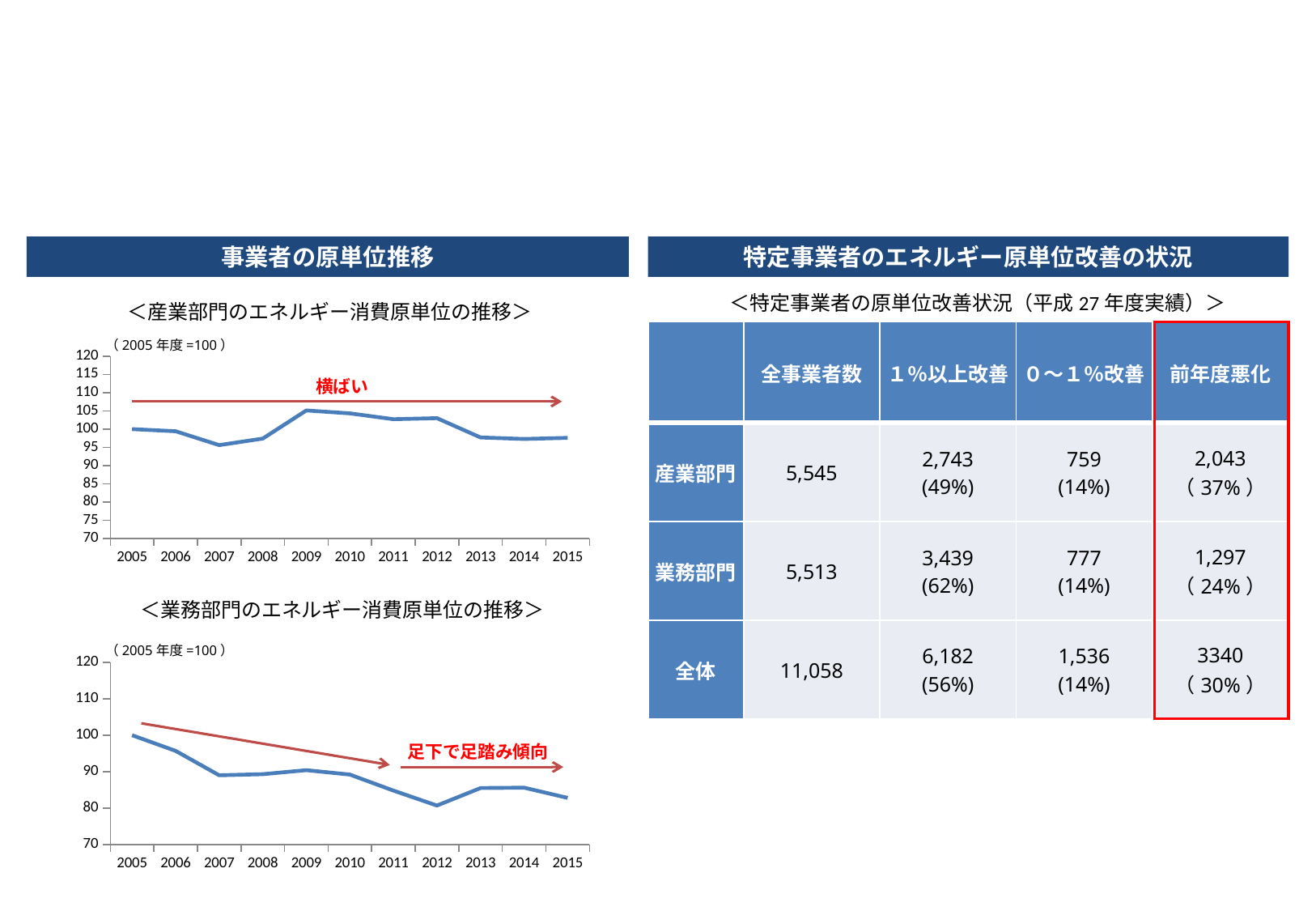
What kind of chart is the ＜産業部門のエネルギー消費原単位の推移＞ chart? line chart In the ＜業務部門のエネルギー消費原単位の推移＞ chart, which year has the highest value? 2005 In the ＜産業部門のエネルギー消費原単位の推移＞ chart, which is larger, the value for 2009 or the value for 2013? 2009 In the ＜産業部門のエネルギー消費原単位の推移＞ chart, is the value for 2009 greater or less than 100? greater In the ＜業務部門のエネルギー消費原単位の推移＞ chart, is the value for 2012 greater or less than 85? less In the ＜業務部門のエネルギー消費原単位の推移＞ chart, do the values generally rise or fall from 2005 to 2015? fall How many years are plotted in the ＜業務部門のエネルギー消費原単位の推移＞ chart? 11 In the ＜産業部門のエネルギー消費原単位の推移＞ chart, which year has the highest value? 2009 What red annotation text is written above the line in the ＜産業部門のエネルギー消費原単位の推移＞ chart? 横ばい In the ＜産業部門のエネルギー消費原単位の推移＞ chart, what is the value for 2005? 100 In the ＜産業部門のエネルギー消費原単位の推移＞ chart, is the value for 2007 greater or less than 100? less In the ＜業務部門のエネルギー消費原単位の推移＞ chart, which year has the lowest value? 2012